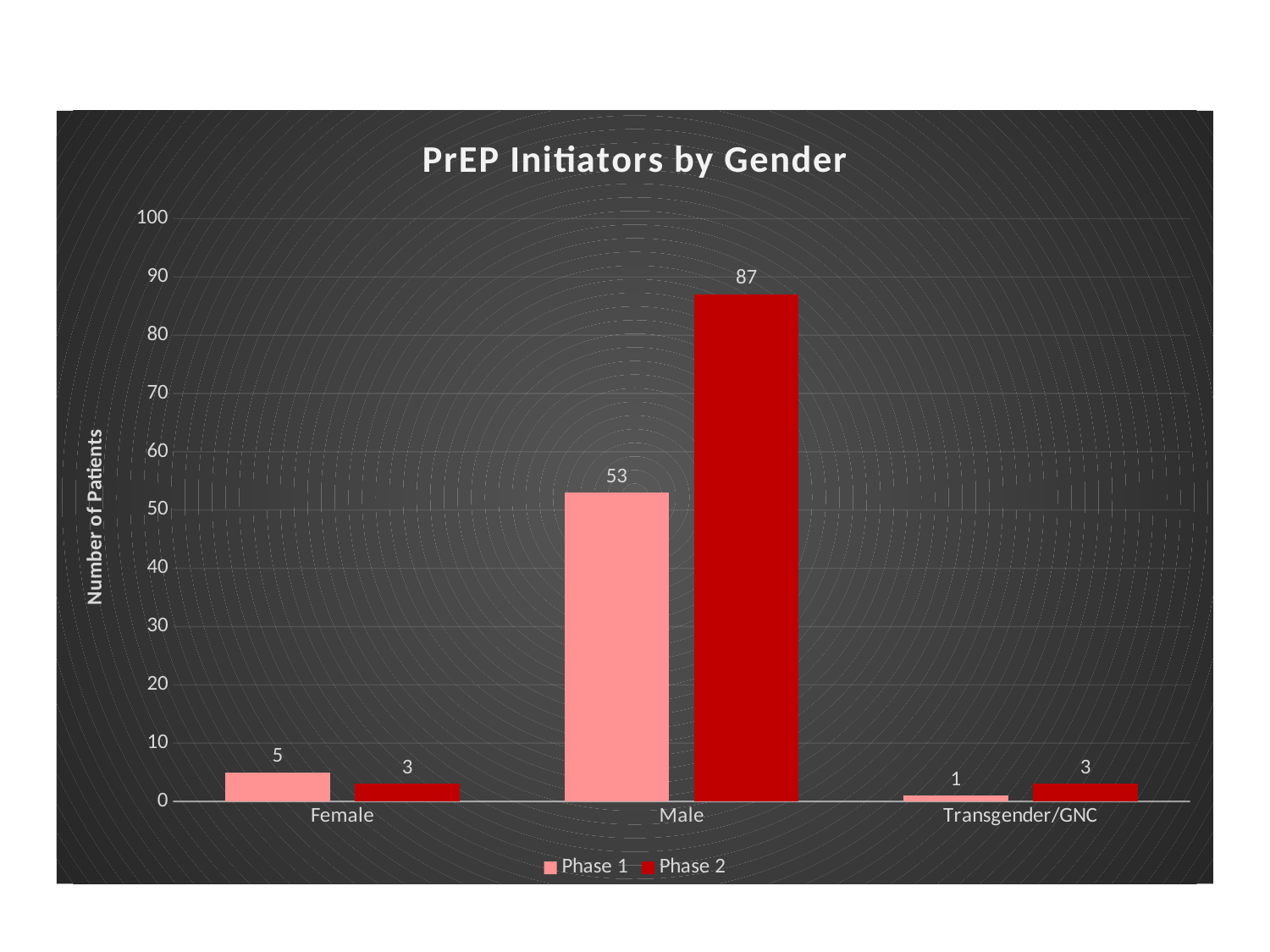
Which category has the lowest Phase 1 value? Transgender/GNC Which category has the highest Phase 2 value? Male What is the difference between the Phase 2 and Phase 1 values for Male? 34 What is the Phase 1 value for Female? 5 What kind of chart is shown? Bar chart What is the title of the chart? PrEP Initiators by Gender What is the Phase 2 value for Transgender/GNC? 3 How many categories are shown on the x axis? 3 Which is larger for Female: the Phase 1 value or the Phase 2 value? Phase 1 What is the Phase 2 value for Male? 87 How many series does the legend list? 2 What is the Phase 1 value for Male? 53